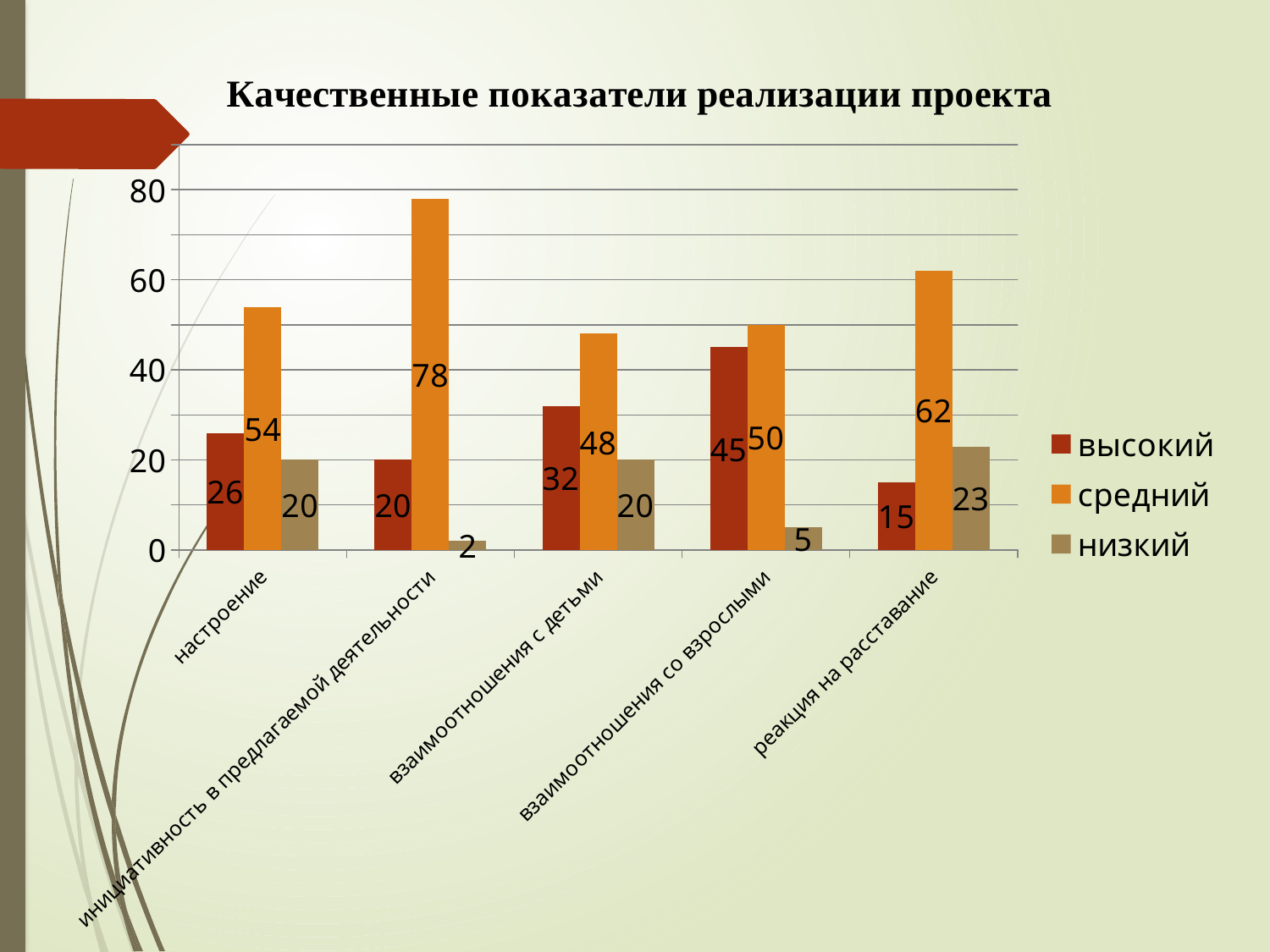
What is the title of the chart? Качественные показатели реализации проекта How many series does the legend list? 3 What is the value of the низкий series for реакция на расставание? 23 Which category has the highest value in the средний series? инициативность в предлагаемой деятельности What is the difference between the средний and высокий values for настроение? 28 What kind of chart is shown on the slide? bar chart Which is larger for взаимоотношения с детьми: the высокий value or the низкий value? высокий How many categories are shown on the x axis? 5 Is the средний value for реакция на расставание greater or less than 60? greater What is the value of the средний series for инициативность в предлагаемой деятельности? 78 Which category has the lowest value in the низкий series? инициативность в предлагаемой деятельности What is the value of the высокий series for взаимоотношения со взрослыми? 45